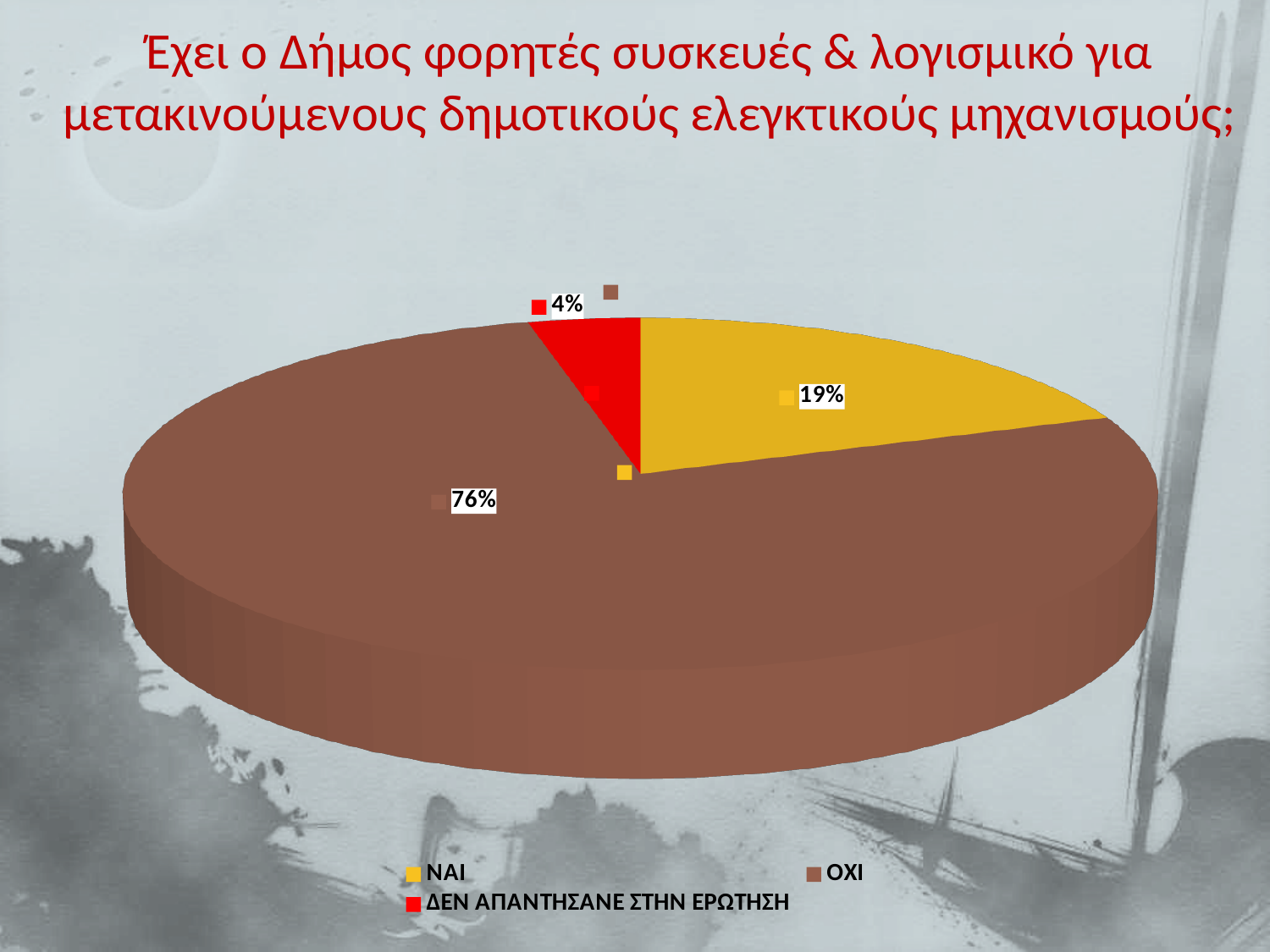
How many entries does the legend list? 3 What is the difference in percentage points between ΝΑΙ and ΔΕΝ ΑΠΑΝΤΗΣΑΝΕ ΣΤΗΝ ΕΡΩΤΗΣΗ? 15 What kind of chart is shown on the slide? Pie chart What share of the pie does ΟΧΙ have? 76% What share of the pie does ΝΑΙ have? 19% What is the difference in percentage points between ΟΧΙ and ΝΑΙ? 57 Which category has the largest slice of the pie? ΟΧΙ Which is larger, the slice for ΝΑΙ or the slice for ΟΧΙ? ΟΧΙ Which category has the smallest slice of the pie? ΔΕΝ ΑΠΑΝΤΗΣΑΝΕ ΣΤΗΝ ΕΡΩΤΗΣΗ What share of the pie does ΔΕΝ ΑΠΑΝΤΗΣΑΝΕ ΣΤΗΝ ΕΡΩΤΗΣΗ have? 4% What colour is the slice for ΟΧΙ? Brown How many slices does the pie chart have? 3